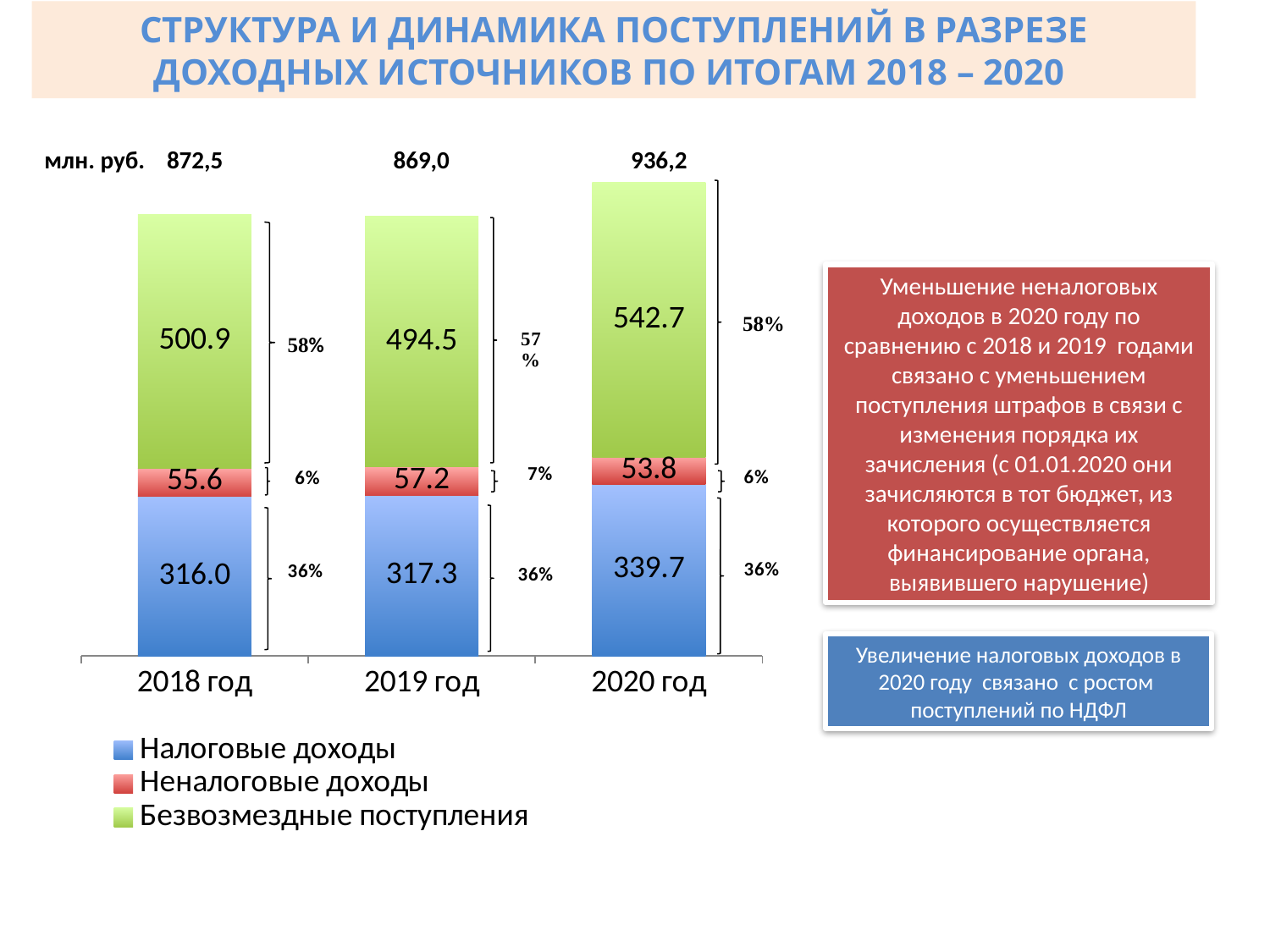
What is the value of Неналоговые доходы for 2018 год? 55.6 What kind of chart is shown on the slide? Stacked bar chart In which year is Безвозмездные поступления the highest? 2020 год What percentage share does Безвозмездные поступления have in 2019 год? 57% What is the value of Налоговые доходы for 2019 год? 317.3 What is the value of Безвозмездные поступления for 2020 год? 542.7 What is the difference between Налоговые доходы in 2020 год and 2018 год? 23.7 Which is larger: Неналоговые доходы in 2019 год or in 2020 год? 2019 год How many years are shown on the x axis? 3 In which year is Неналоговые доходы the lowest? 2020 год How many series does the legend list? 3 What is the total shown above the bar for 2020 год? 936,2